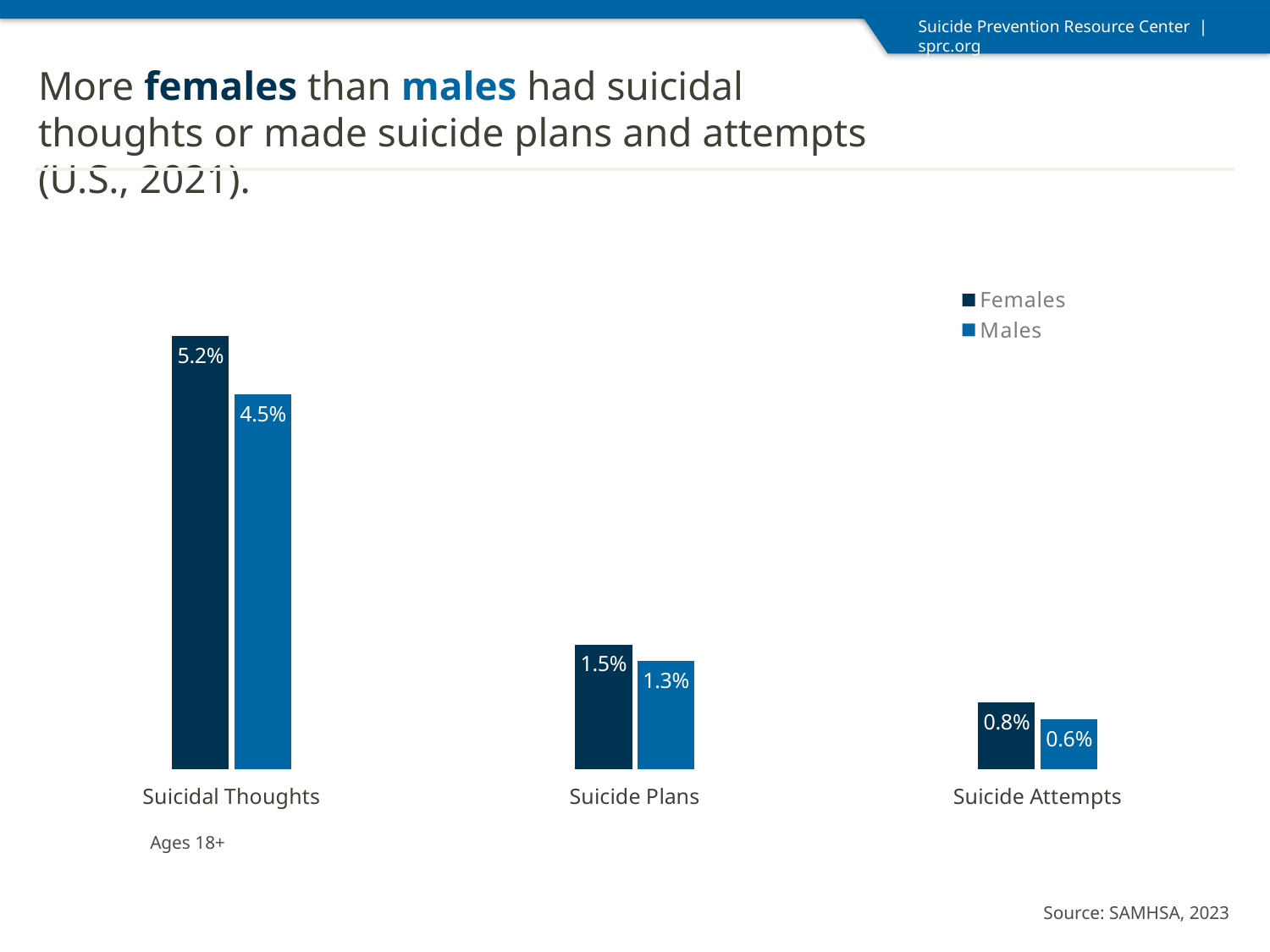
What is the value for females for Suicide Plans? 1.5% Which category has the lowest value for males? Suicide Attempts How many series does the legend list? 2 What kind of chart is shown on the slide? Bar chart Do the values for females rise or fall from Suicidal Thoughts to Suicide Attempts? Fall What percentage of females had suicidal thoughts? 5.2% How many categories are shown on the x axis? 3 Which is larger for Suicide Attempts, the value for females or for males? Females What is the value for males for Suicide Attempts? 0.6% What percentage of males made suicide plans? 1.3% Which category has the highest value for females? Suicidal Thoughts What is the difference between females and males for Suicidal Thoughts? 0.7%